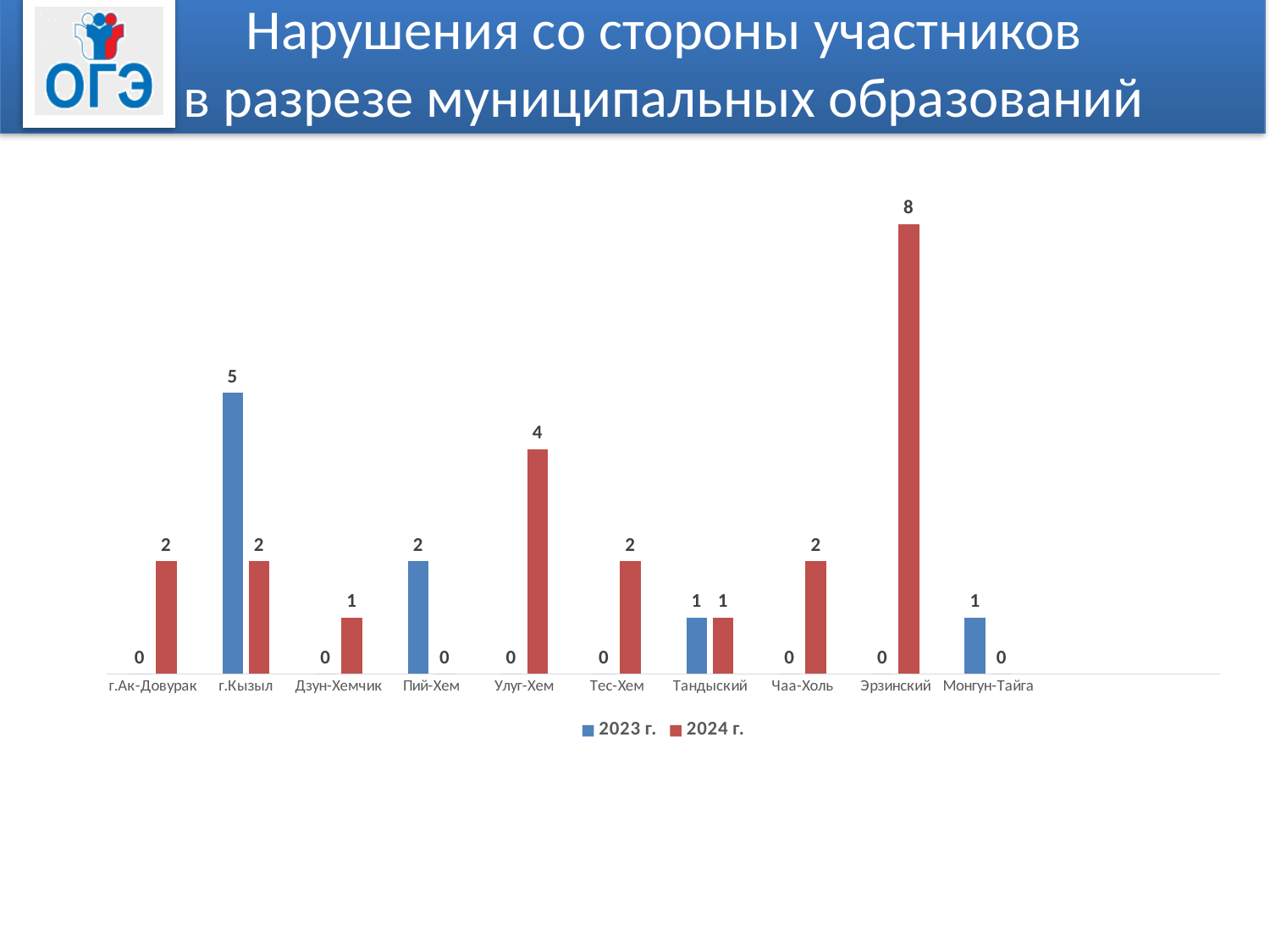
What is the value for Улуг-Хем in the 2024 г. series? 4 How many categories are shown on the x axis? 10 What is the difference between the 2024 г. value for Эрзинский and the 2024 г. value for Улуг-Хем? 4 Which category has the highest value in the 2024 г. series? Эрзинский Which colour represents the 2024 г. series? Red How many series does the legend list? 2 What is the value for Эрзинский in the 2024 г. series? 8 What is the value for г.Кызыл in the 2023 г. series? 5 Which is larger for г.Кызыл: the 2023 г. value or the 2024 г. value? 2023 г. Which category has the highest value in the 2023 г. series? г.Кызыл What kind of chart is shown on the slide? Bar chart What is the value for Пий-Хем in the 2023 г. series? 2